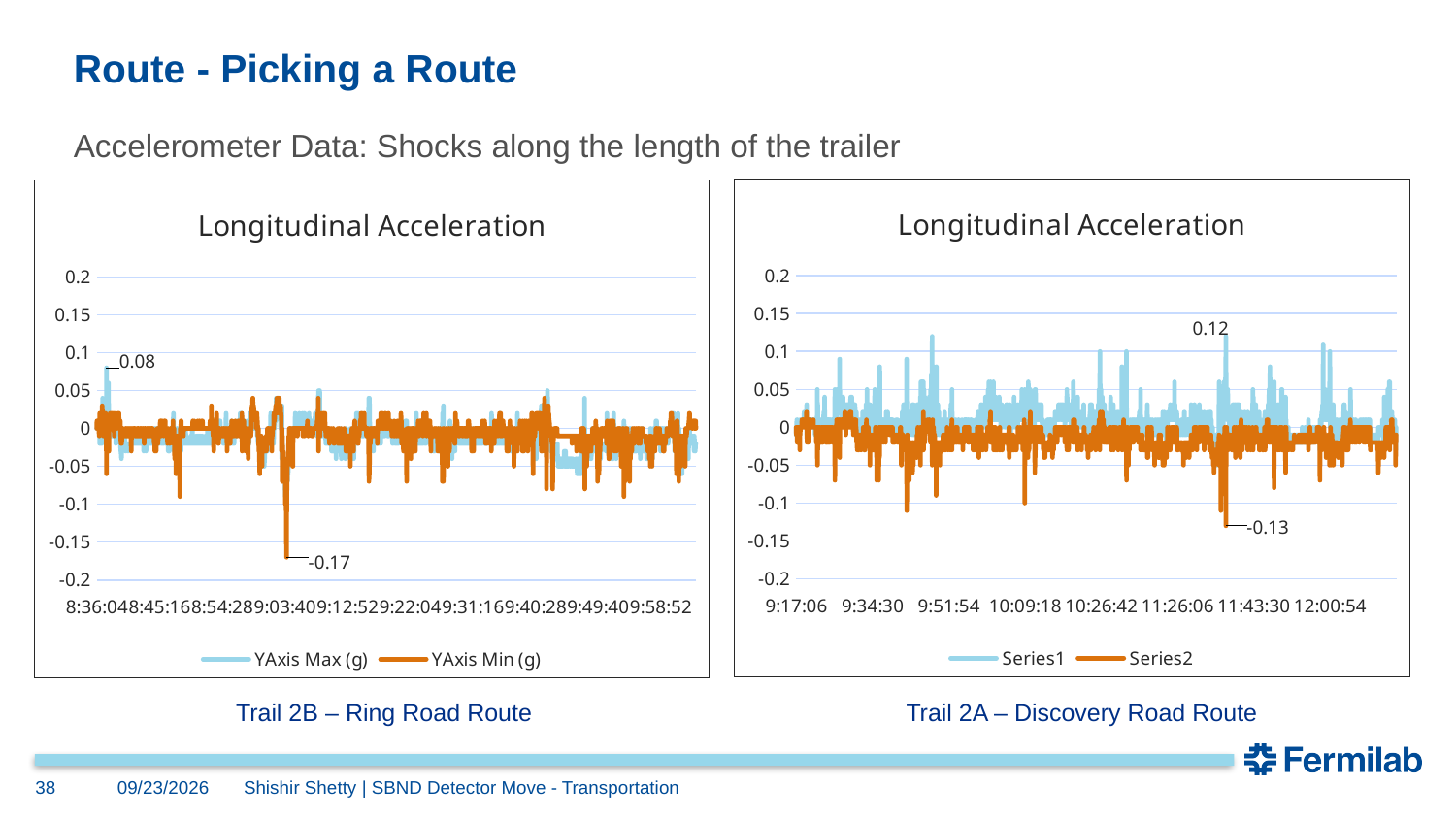
What is the title shown on both charts? Longitudinal Acceleration What kind of chart is the left chart (Trail 2B – Ring Road Route)? Line chart What are the legend entries of the left chart (Trail 2B – Ring Road Route)? YAxis Max (g) and YAxis Min (g) What is the labeled peak value on the right chart (Trail 2A – Discovery Road Route)? 0.12 On the left chart (Trail 2B – Ring Road Route), is the labeled minimum value greater or less than -0.15? less What is the labeled minimum value on the left chart (Trail 2B – Ring Road Route)? -0.17 Which chart has the larger labeled peak value, the left chart (Trail 2B) or the right chart (Trail 2A)? The right chart (Trail 2A), 0.12 What is the labeled peak value on the left chart (Trail 2B – Ring Road Route)? 0.08 How many series does the legend of the left chart (Trail 2B – Ring Road Route) list? 2 What is the labeled minimum value on the right chart (Trail 2A – Discovery Road Route)? -0.13 On the right chart (Trail 2A – Discovery Road Route), what is the difference between the labeled peak 0.12 and the labeled minimum -0.13? 0.25 How many series does the legend of the right chart (Trail 2A – Discovery Road Route) list? 2